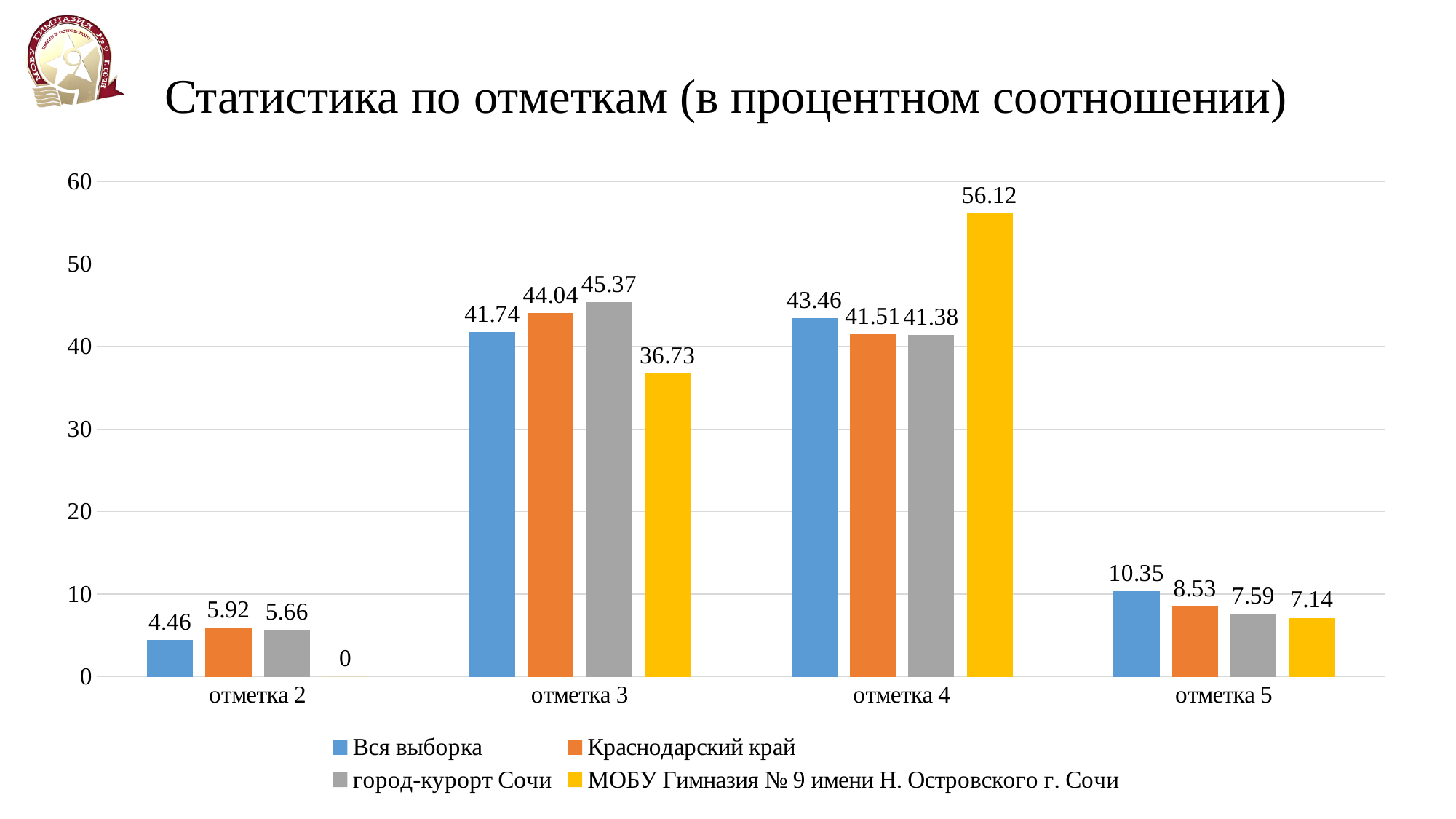
Is the value for город-курорт Сочи at отметка 3 greater or less than 40? greater What is the value for Вся выборка at отметка 3? 41.74 What is the value for город-курорт Сочи at отметка 2? 5.66 How many series does the legend list? 4 What kind of chart is shown on the slide? Bar chart What is the difference between the МОБУ Гимназия № 9 value and the Вся выборка value at отметка 4? 12.66 Which series has the highest value at отметка 4? МОБУ Гимназия № 9 имени Н. Островского г. Сочи Which series has the lowest value at отметка 3? МОБУ Гимназия № 9 имени Н. Островского г. Сочи What is the value for МОБУ Гимназия № 9 имени Н. Островского г. Сочи at отметка 4? 56.12 Which is larger at отметка 5: Вся выборка or Краснодарский край? Вся выборка How many categories are shown on the x axis? 4 What is the value for Краснодарский край at отметка 5? 8.53